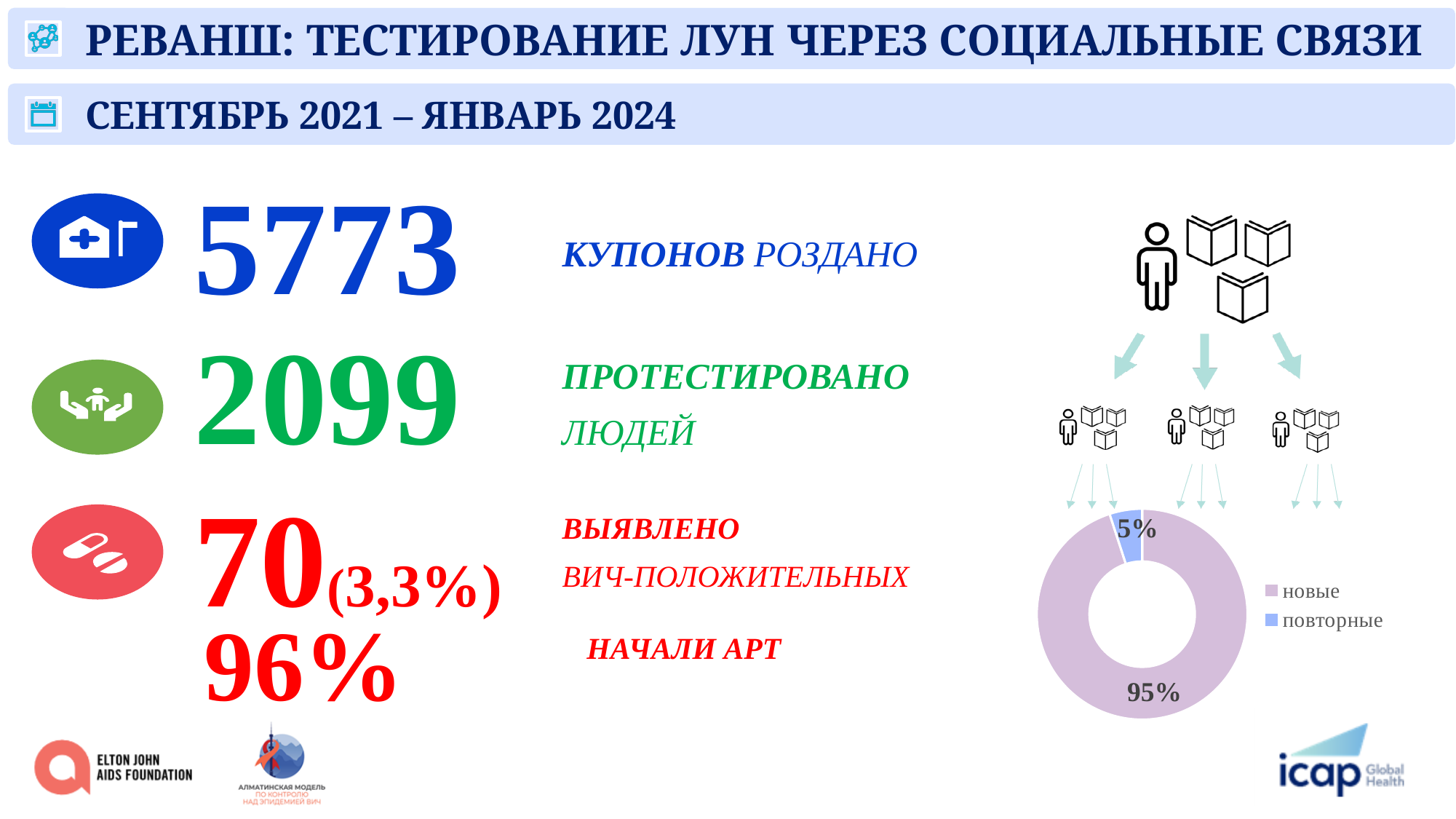
In the donut chart, what share is labelled for "новые"? 95% What colour is the "повторные" slice in the donut chart? Blue What kind of chart is shown on the right side of the slide? Donut (pie) chart In the donut chart, what share is labelled for "повторные"? 5% What colour is the "новые" slice in the donut chart? Light purple Which slice of the donut chart is the smallest? повторные Which slice of the donut chart is the largest? новые In the donut chart, which is larger: "новые" or "повторные"? новые How many entries does the legend of the donut chart list? 2 How many slices does the donut chart have? 2 What is the difference in percentage points between the "новые" and "повторные" slices of the donut chart? 90